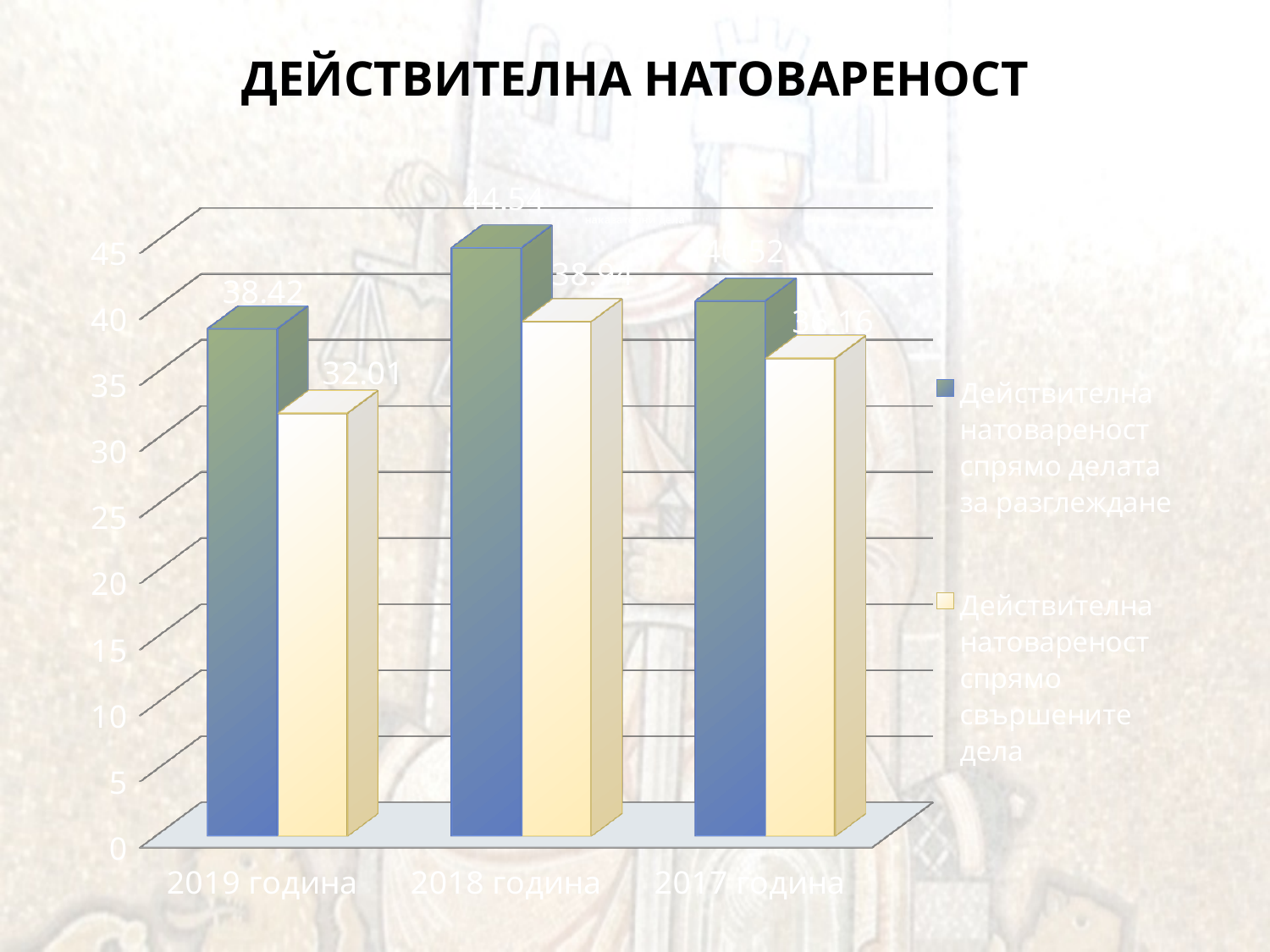
What is the value of 'Действителна натовареност спрямо делата за разглеждане' for 2018 година? 44.54 What is the value of 'Действителна натовареност спрямо делата за разглеждане' for 2019 година? 38.42 Which year has the highest value for 'Действителна натовареност спрямо делата за разглеждане'? 2018 година Is the value of 'Действителна натовареност спрямо делата за разглеждане' for 2017 година greater or less than 35? greater What is the value of 'Действителна натовареност спрямо свършените дела' for 2017 година? 36.16 How many series does the legend list? 2 What is the value of 'Действителна натовареност спрямо свършените дела' for 2019 година? 32.01 What type of chart is shown on the slide? bar chart Which year has the lowest value for 'Действителна натовареност спрямо свършените дела'? 2019 година What is the difference between the two series' values for 2019 година? 6.41 What is the title of the chart? ДЕЙСТВИТЕЛНА НАТОВАРЕНОСТ What is the value of 'Действителна натовареност спрямо свършените дела' for 2018 година? 38.94